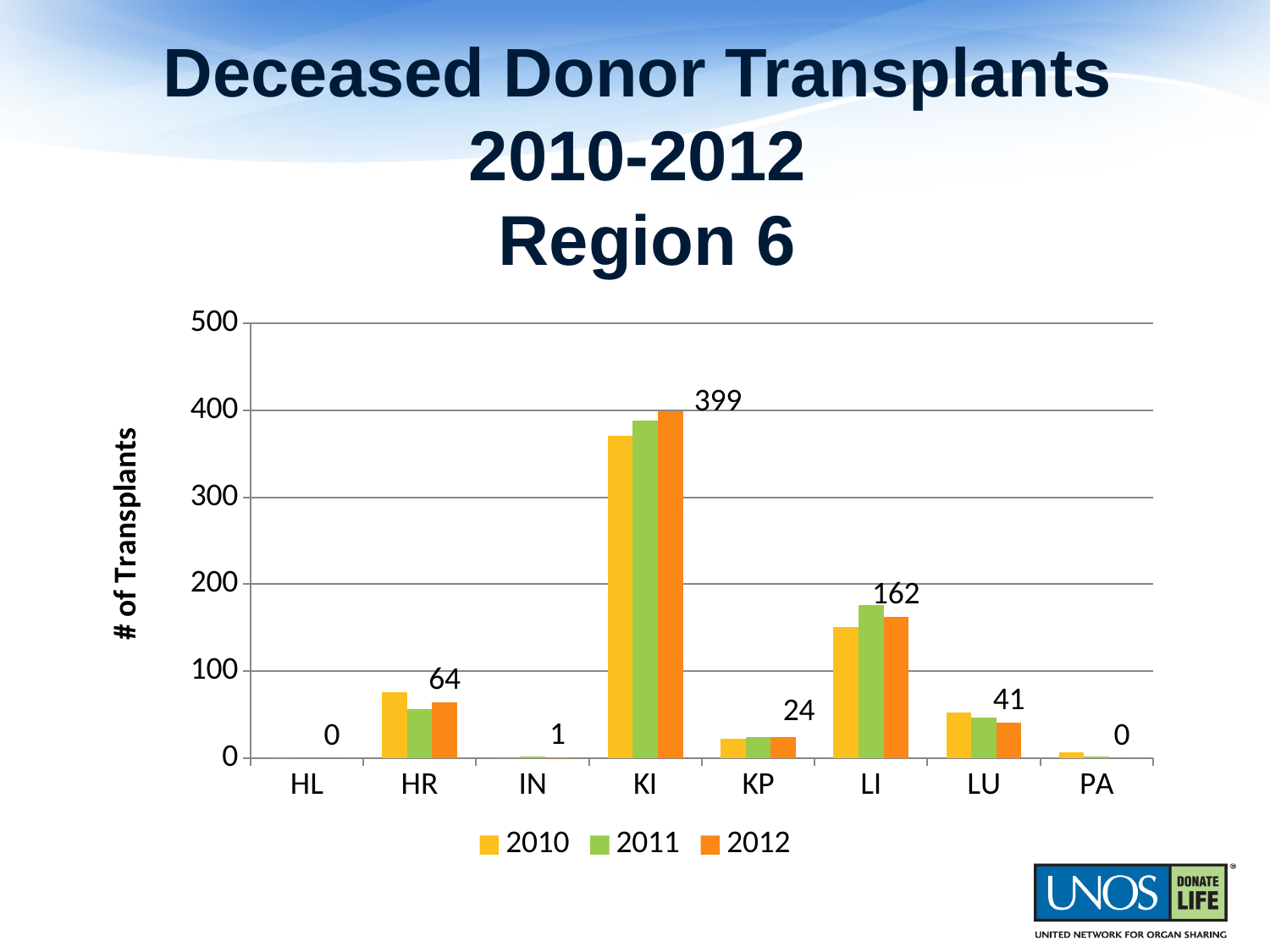
How many series does the legend list? 3 What is the value for LI in 2012? 162 What kind of chart is shown on the slide? Bar chart Which is larger in 2012, HR or LU? HR Is the value for KI in 2010 greater or less than 300? greater What is the value for HR in 2012? 64 What is the difference between the 2012 values for KI and LI? 237 What is the value for LU in 2012? 41 Is the value for LI in 2011 greater or less than 200? less Which category has the highest number of transplants in 2012? KI What is the value for KI in 2012? 399 How many categories are shown on the x axis? 8